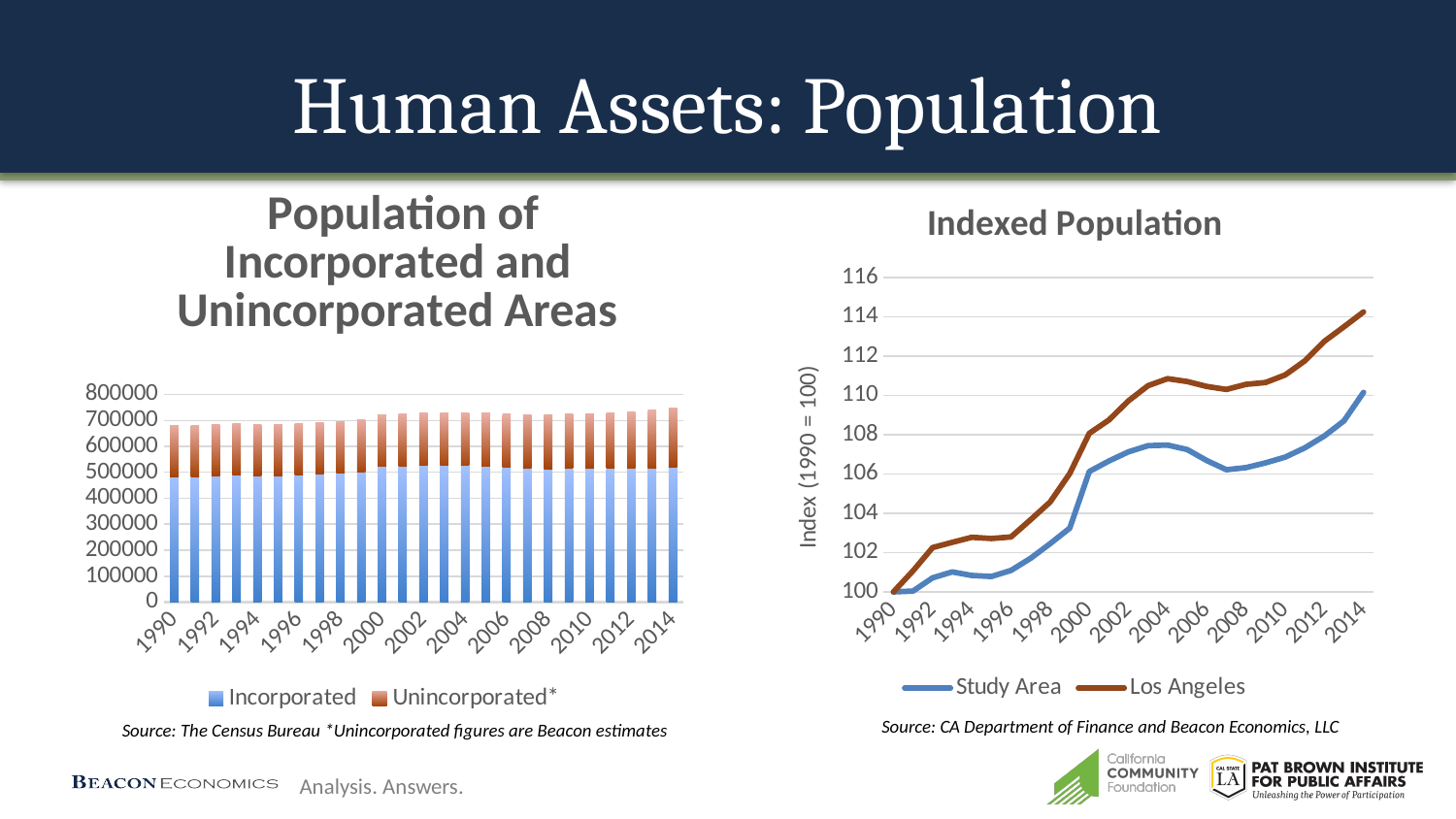
In the 'Population of Incorporated and Unincorporated Areas' chart, is the total stacked bar for 2014 greater or less than 700000? greater In the 'Indexed Population' chart, what is the value of both series in 1990? 100 In the 'Indexed Population' chart, is the Los Angeles value for 2014 greater or less than 112? greater How many series does the legend of the 'Population of Incorporated and Unincorporated Areas' chart list? 2 In the 'Population of Incorporated and Unincorporated Areas' chart, is the Incorporated value for 1990 greater or less than 400000? greater How many series does the legend of the 'Indexed Population' chart list? 2 What kind of chart is the 'Indexed Population' chart? Line chart In the 'Indexed Population' chart, does the Study Area line rise or fall between 2004 and 2008? Fall What kind of chart is the 'Population of Incorporated and Unincorporated Areas' chart? Bar chart In the 'Indexed Population' chart, which series is higher in 2014, Study Area or Los Angeles? Los Angeles In the 'Population of Incorporated and Unincorporated Areas' chart, what are the two legend entries? Incorporated and Unincorporated*